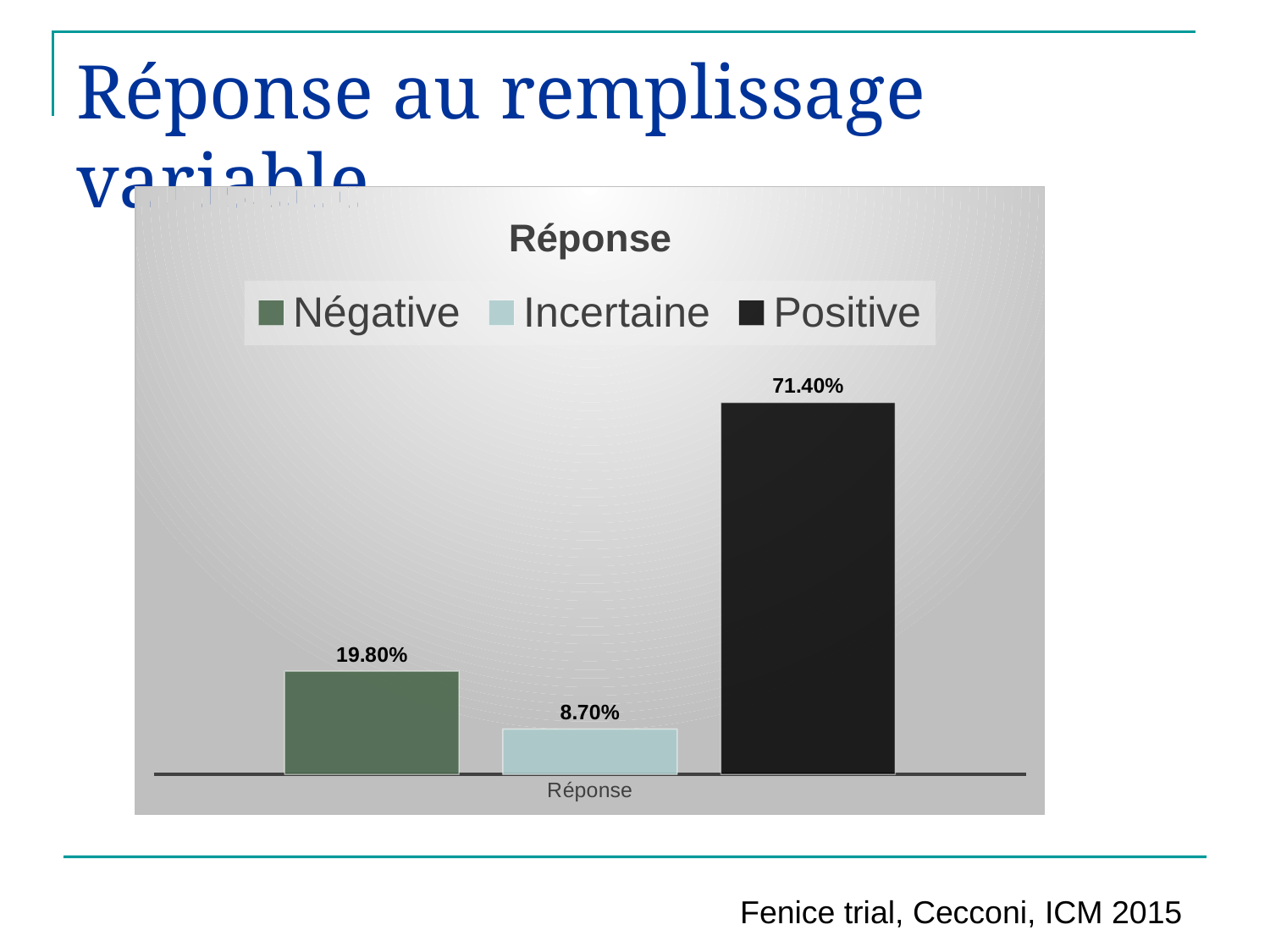
What is the value for Incertaine? 8.70% What is the value for Positive? 71.40% How many series does the legend list? 3 What colour is the Positive bar? Black What is the difference between the Positive and Négative values? 51.60% Which series has the highest value? Positive What is the title of the chart? Réponse What is the difference between the Négative and Incertaine values? 11.10% Which is larger, Négative or Incertaine? Négative What kind of chart is shown? Bar chart Which series has the lowest value? Incertaine What is the value for Négative? 19.80%